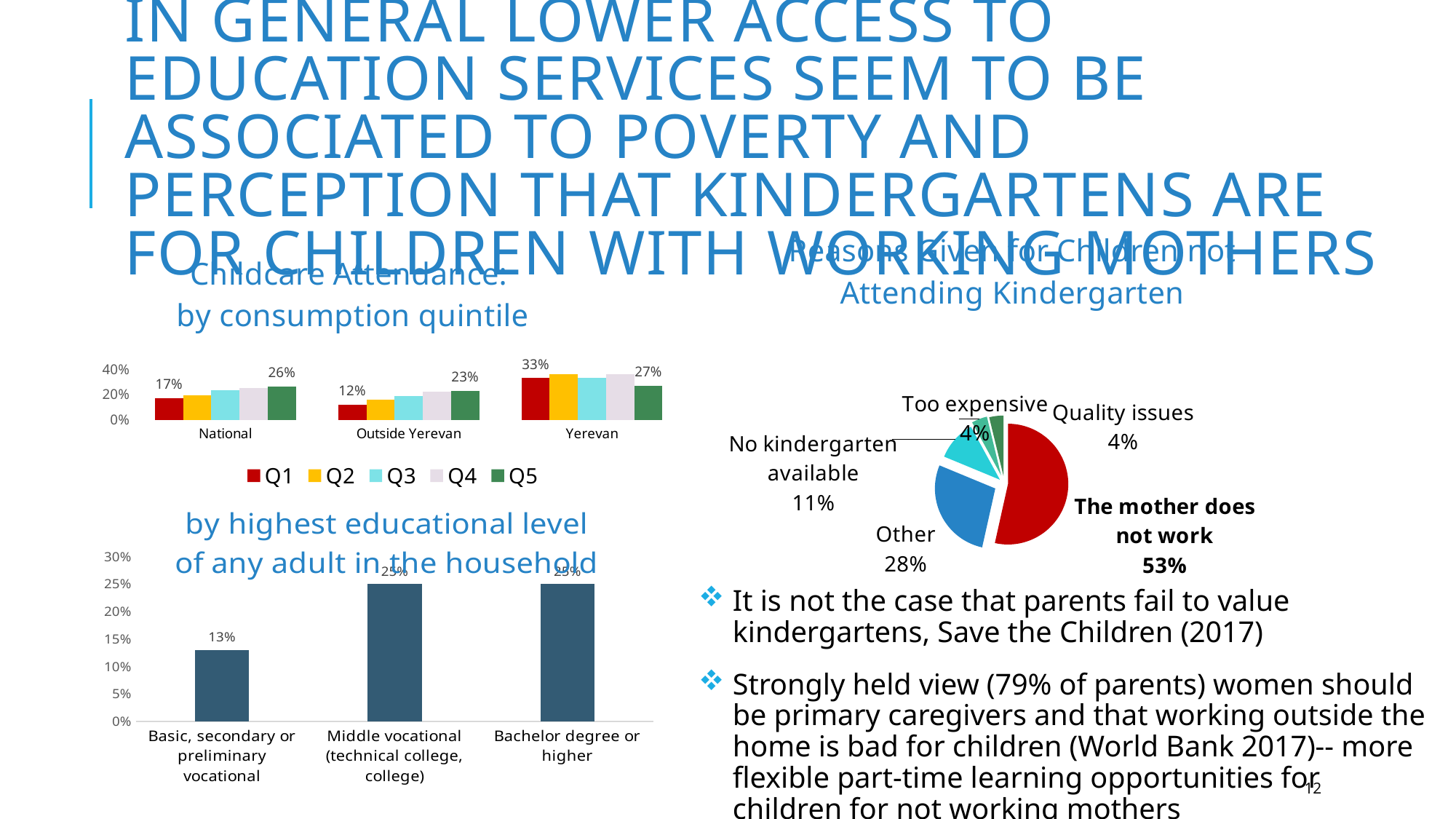
In the 'by highest educational level of any adult in the household' chart, how many categories are shown? 3 In the 'by highest educational level of any adult in the household' chart, which category has the lowest value? Basic, secondary or preliminary vocational In the 'Childcare Attendance: by consumption quintile' chart, is the Q1 value for Yerevan greater or less than 20%? greater In the 'Reasons Given for Children not Attending Kindergarten' pie chart, which is larger: 'Other' or 'No kindergarten available'? Other In the 'Childcare Attendance: by consumption quintile' chart, what is the difference between the Q5 and Q1 values in the National group? 9% In the 'Childcare Attendance: by consumption quintile' chart, what is the value for Q1 in the National group? 17% In the 'by highest educational level of any adult in the household' chart, what is the value for 'Basic, secondary or preliminary vocational'? 13% In the 'Childcare Attendance: by consumption quintile' chart, what is the value for Q1 in the Outside Yerevan group? 12% What kind of chart is the 'Reasons Given for Children not Attending Kindergarten' chart? Pie chart In the 'Childcare Attendance: by consumption quintile' chart, how many series does the legend list? 5 In the 'Childcare Attendance: by consumption quintile' chart, what is the value for Q5 in the Yerevan group? 27% In the 'Reasons Given for Children not Attending Kindergarten' pie chart, what share is 'The mother does not work'? 53%